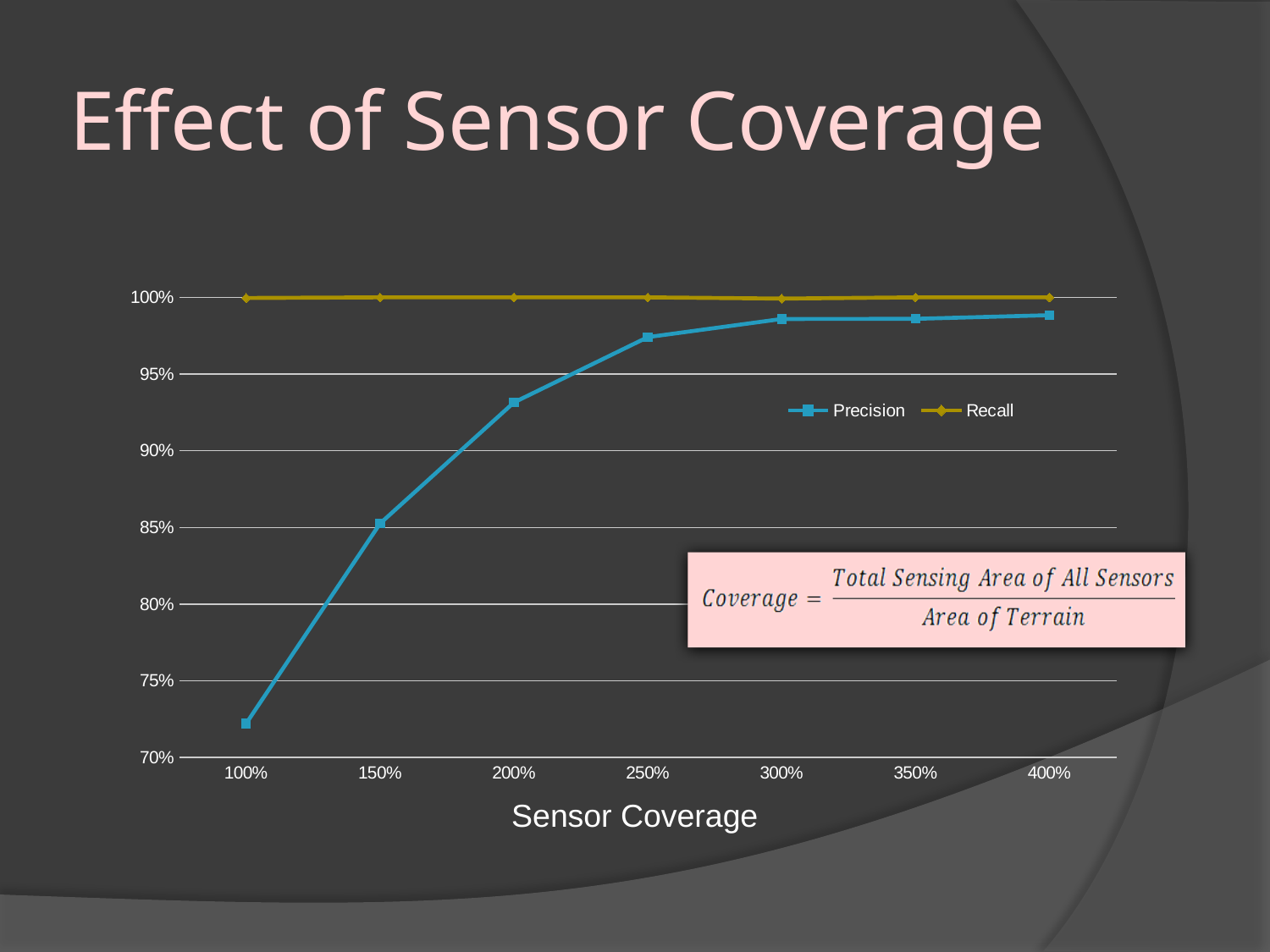
At which sensor coverage value is Precision lowest? 100% How many series does the legend list? 2 Is the Precision value at 200% sensor coverage greater or less than 90%? greater How many sensor coverage values are plotted along the x axis? 7 What is the title of the x axis? Sensor Coverage At 100% sensor coverage, which series has the larger value, Precision or Recall? Recall Is the Recall value at 100% sensor coverage greater or less than 95%? greater Does Precision rise or fall as sensor coverage increases along the x axis? rise Is the Precision value at 250% sensor coverage greater or less than 95%? greater What kind of chart is shown on the slide? line chart What are the two series named in the legend? Precision and Recall